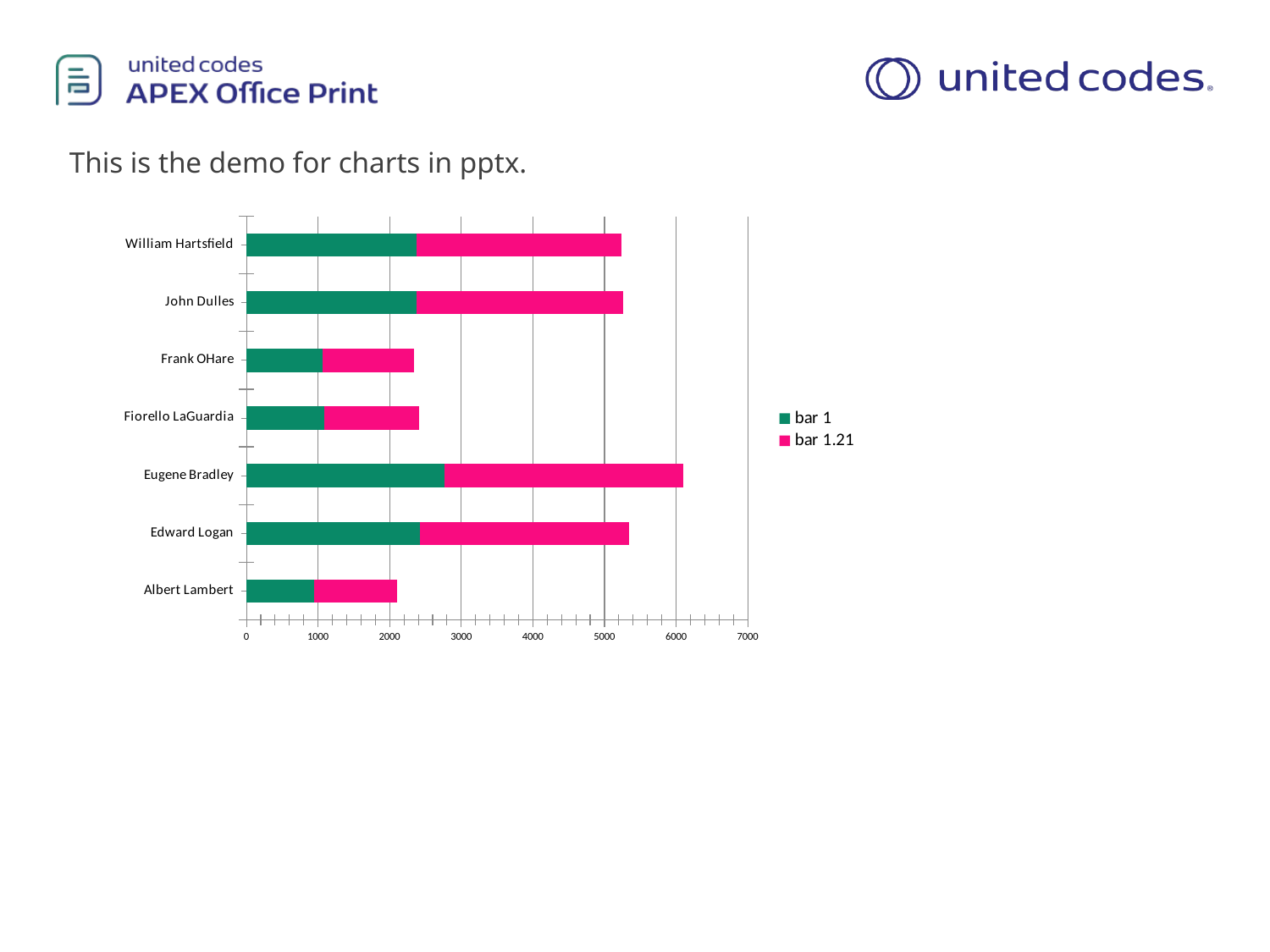
Which has the longer total bar, Edward Logan or Albert Lambert? Edward Logan Is the 'bar 1' value for Frank OHare greater or less than 2000? less What are the two series names shown in the legend? bar 1 and bar 1.21 Is the total bar for Albert Lambert greater or less than 3000? less Is the total bar for Eugene Bradley greater or less than 6000? greater What kind of chart is shown on the slide? bar chart How many categories (names) are plotted on the chart? 7 How many series does the chart legend list? 2 Which category has the longest total bar? Eugene Bradley Which has the longer total bar, Frank OHare or John Dulles? John Dulles